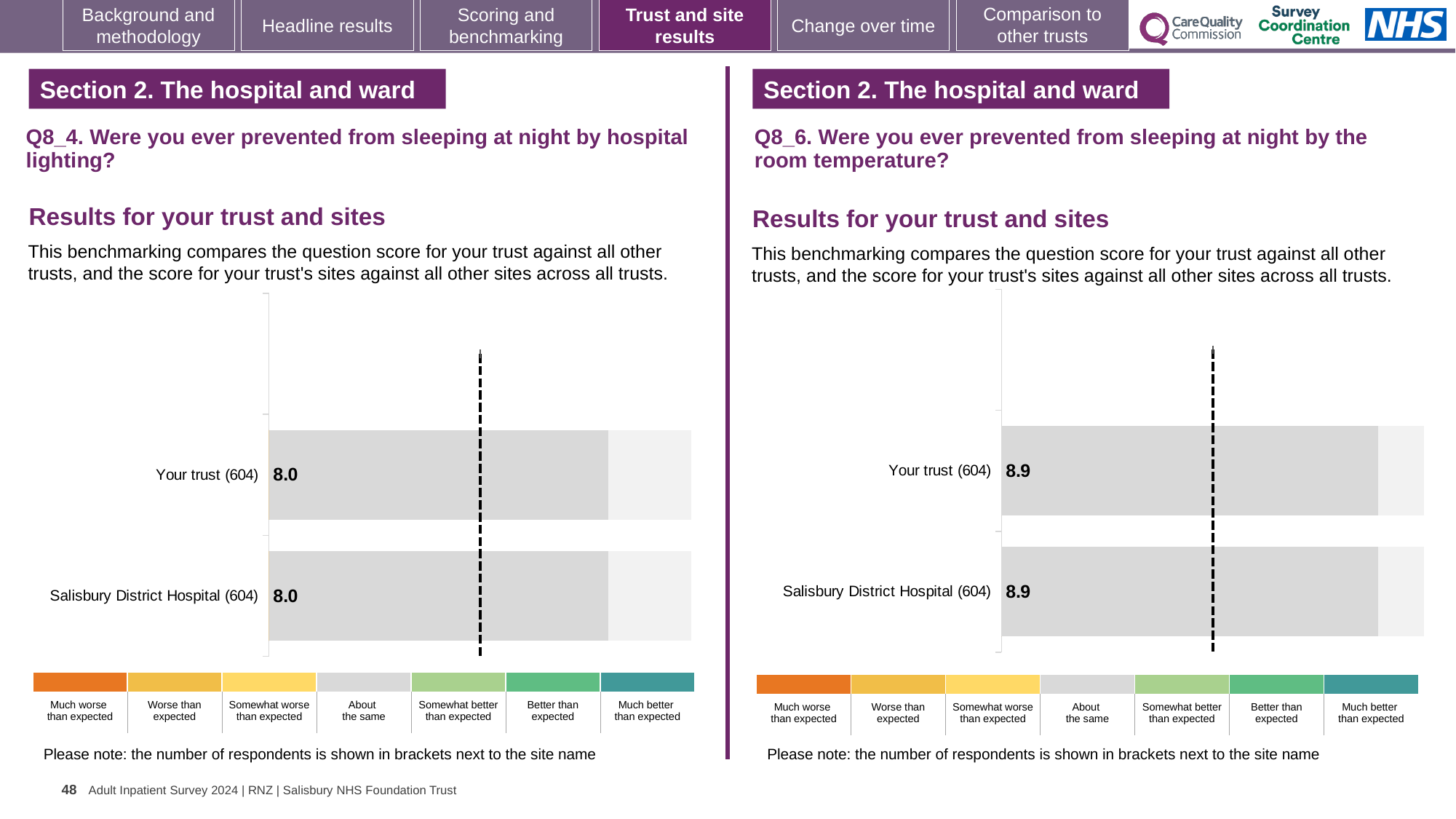
In the Q8_6 chart (room temperature), what is the difference between the Your trust score and the Salisbury District Hospital score? 0.0 How many respondents are shown in brackets for Your trust in the Q8_4 chart (hospital lighting)? 604 In the Q8_4 chart (hospital lighting), what is the score for Your trust (604)? 8.0 In the Q8_4 chart (hospital lighting), which benchmark category does the grey colour of the bars correspond to in the legend? About the same How many bars are plotted in the Q8_6 chart (room temperature)? 2 In the Q8_6 chart (room temperature), what is the score for Salisbury District Hospital (604)? 8.9 In the Q8_4 chart (hospital lighting), what is the score for Salisbury District Hospital (604)? 8.0 In the Q8_6 chart (room temperature), what is the score for Your trust (604)? 8.9 What type of chart is used in the Q8_6 chart (room temperature)? Bar chart Which is larger: the Your trust score in the Q8_4 chart (hospital lighting) or the Your trust score in the Q8_6 chart (room temperature)? Q8_6 (room temperature) How many bars are plotted in the Q8_4 chart (hospital lighting)? 2 In the Q8_4 chart (hospital lighting), what is the difference between the Your trust score and the Salisbury District Hospital score? 0.0